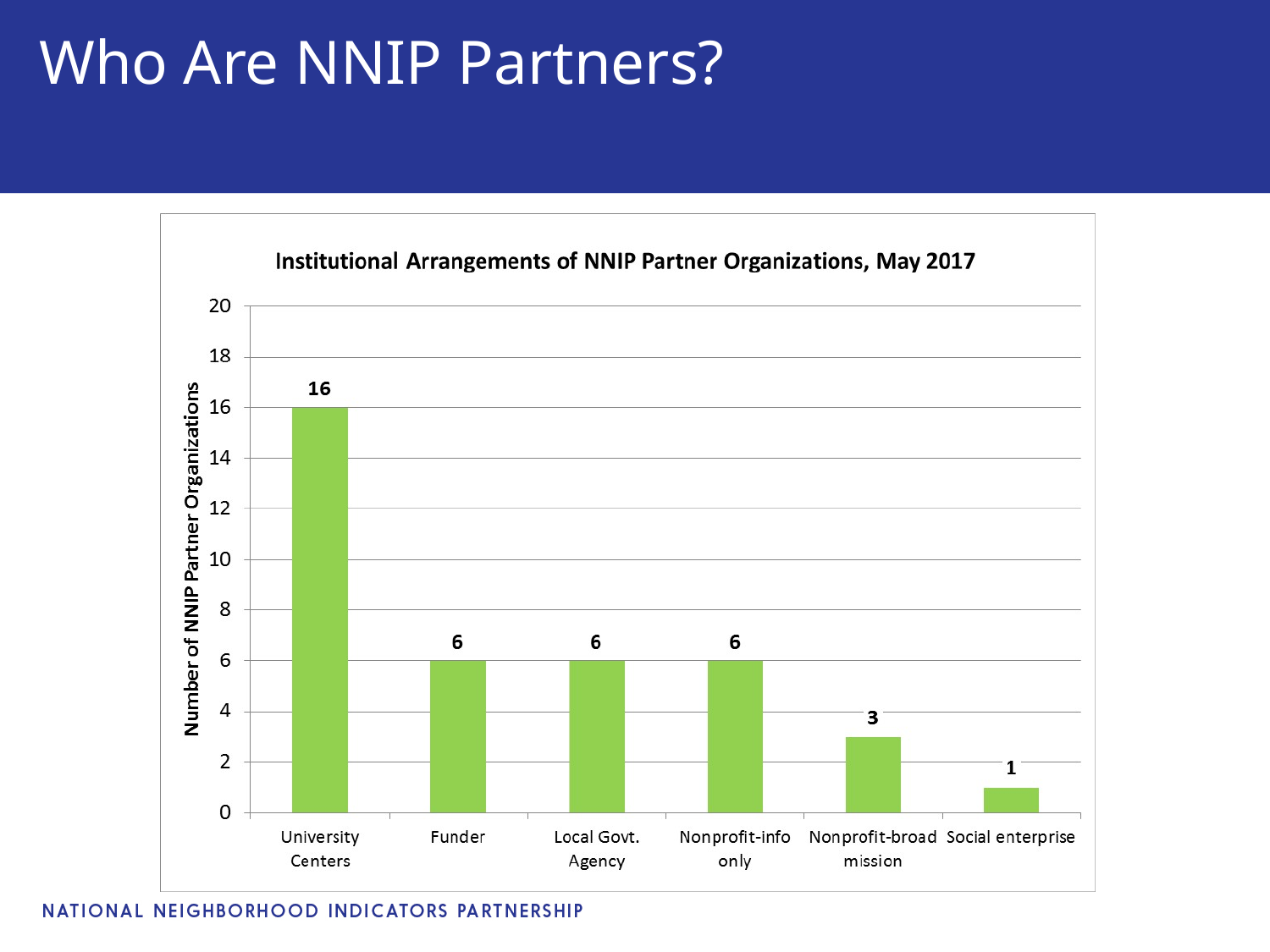
What is the difference between the values for University Centers and Funder? 10 What is the value for Nonprofit-broad mission? 3 Which is larger, the value for Local Govt. Agency or the value for Nonprofit-broad mission? Local Govt. Agency What is the difference between the values for Nonprofit-broad mission and Social enterprise? 2 Which category has the lowest number of NNIP partner organizations? Social enterprise What is the value for Social enterprise? 1 How many categories are shown on the x axis? 6 What is the title of the chart? Institutional Arrangements of NNIP Partner Organizations, May 2017 What kind of chart is shown on the slide? Bar chart What is the value for University Centers? 16 Is the value for University Centers greater or less than 14? greater Which category has the highest number of NNIP partner organizations? University Centers